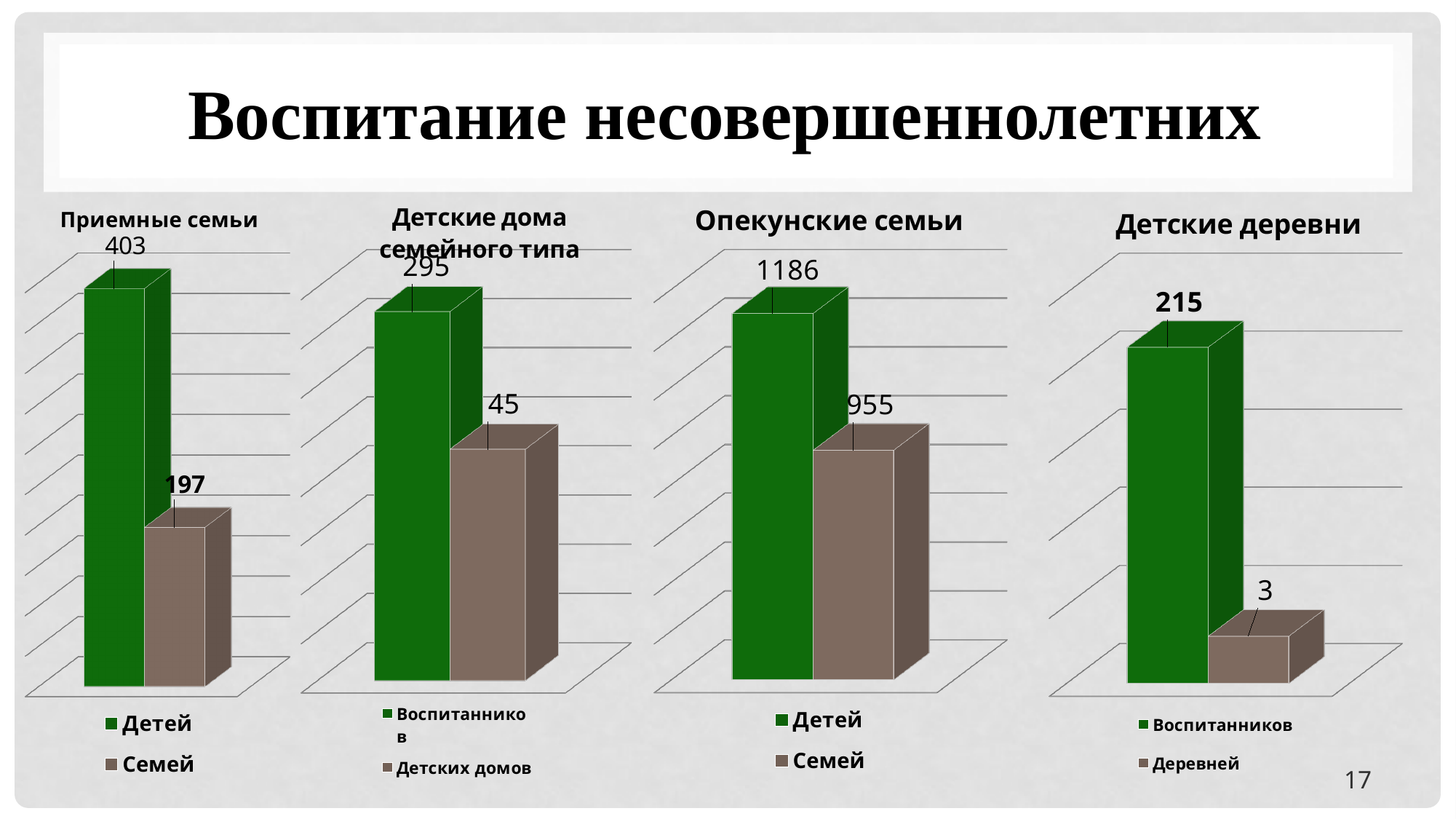
In the chart titled "Детские дома семейного типа", which is larger: "Воспитанников" or "Детских домов"? Воспитанников How many charts are shown on the slide? 4 In the chart titled "Опекунские семьи", what is the value for "Детей"? 1186 In the chart titled "Опекунские семьи", what is the difference between the values for "Детей" and "Семей"? 231 In the chart titled "Приемные семьи", what is the value for "Детей"? 403 In the chart titled "Приемные семьи", what is the difference between the values for "Детей" and "Семей"? 206 How many series does the legend of the chart titled "Опекунские семьи" list? 2 In the chart titled "Детские деревни", which bar is the lowest? Деревней In the chart titled "Детские дома семейного типа", what is the value for "Детских домов"? 45 In the chart titled "Детские деревни", what is the value for "Деревней"? 3 In the chart titled "Приемные семьи", what is the value for "Семей"? 197 What kind of chart is the chart titled "Детские деревни"? Bar chart